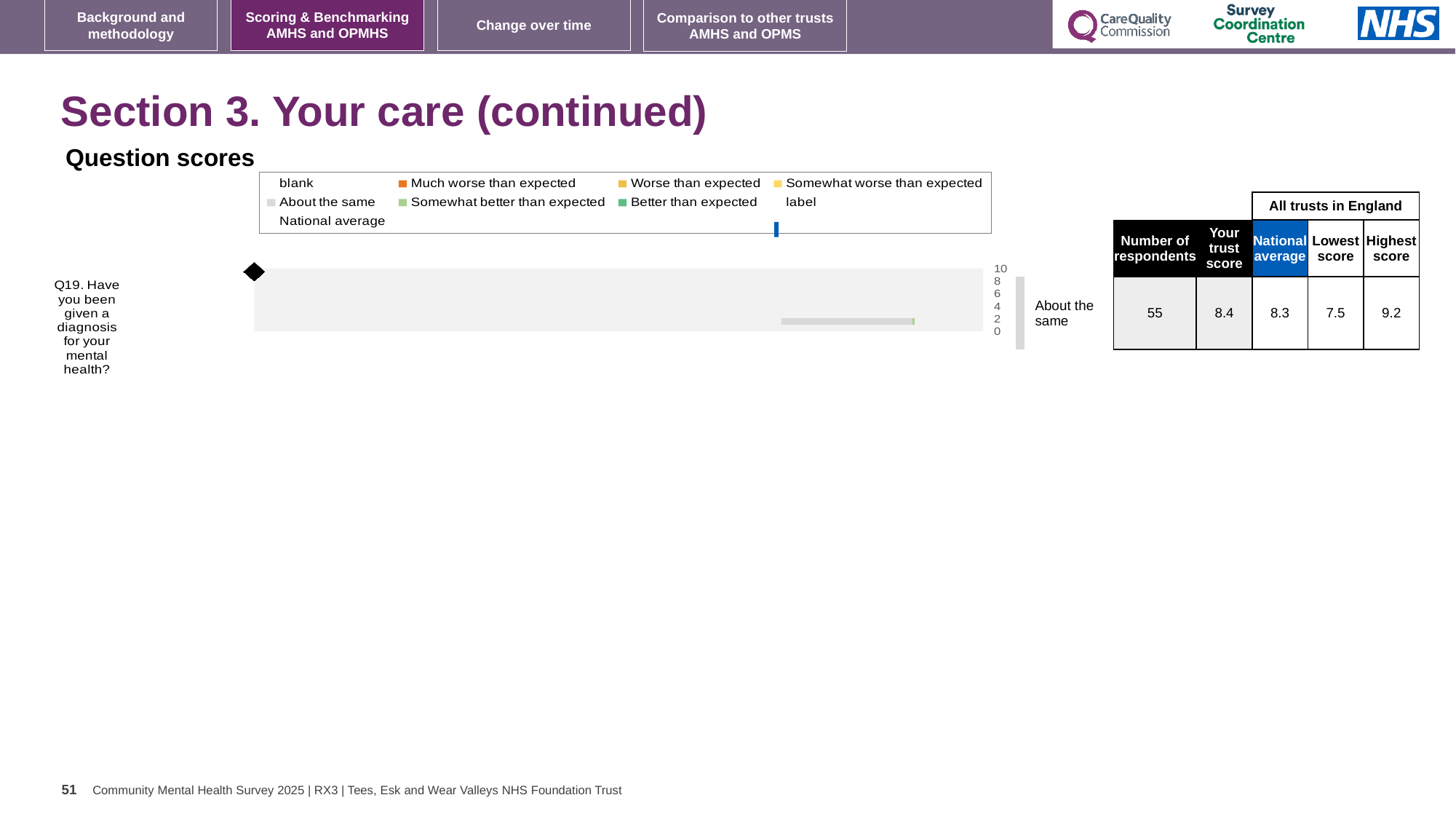
By how much does the trust score for Q19 exceed the national average? 0.1 How many respondents answered Q19? 55 What is the lowest score among all trusts in England for Q19? 7.5 What is the difference between the highest and lowest scores for Q19 across all trusts in England? 1.7 What is the highest score among all trusts in England for Q19? 9.2 How many questions are plotted in the Question scores chart? 1 What is the title of the chart on this slide? Question scores What is the national average score for Q19? 8.3 Which benchmark category is shown for Q19 in the Question scores chart? About the same What is the trust score for Q19 (Have you been given a diagnosis for your mental health?)? 8.4 What kind of chart is used to show the question scores on this slide? bar chart For Q19, which is larger: the trust score or the national average? the trust score